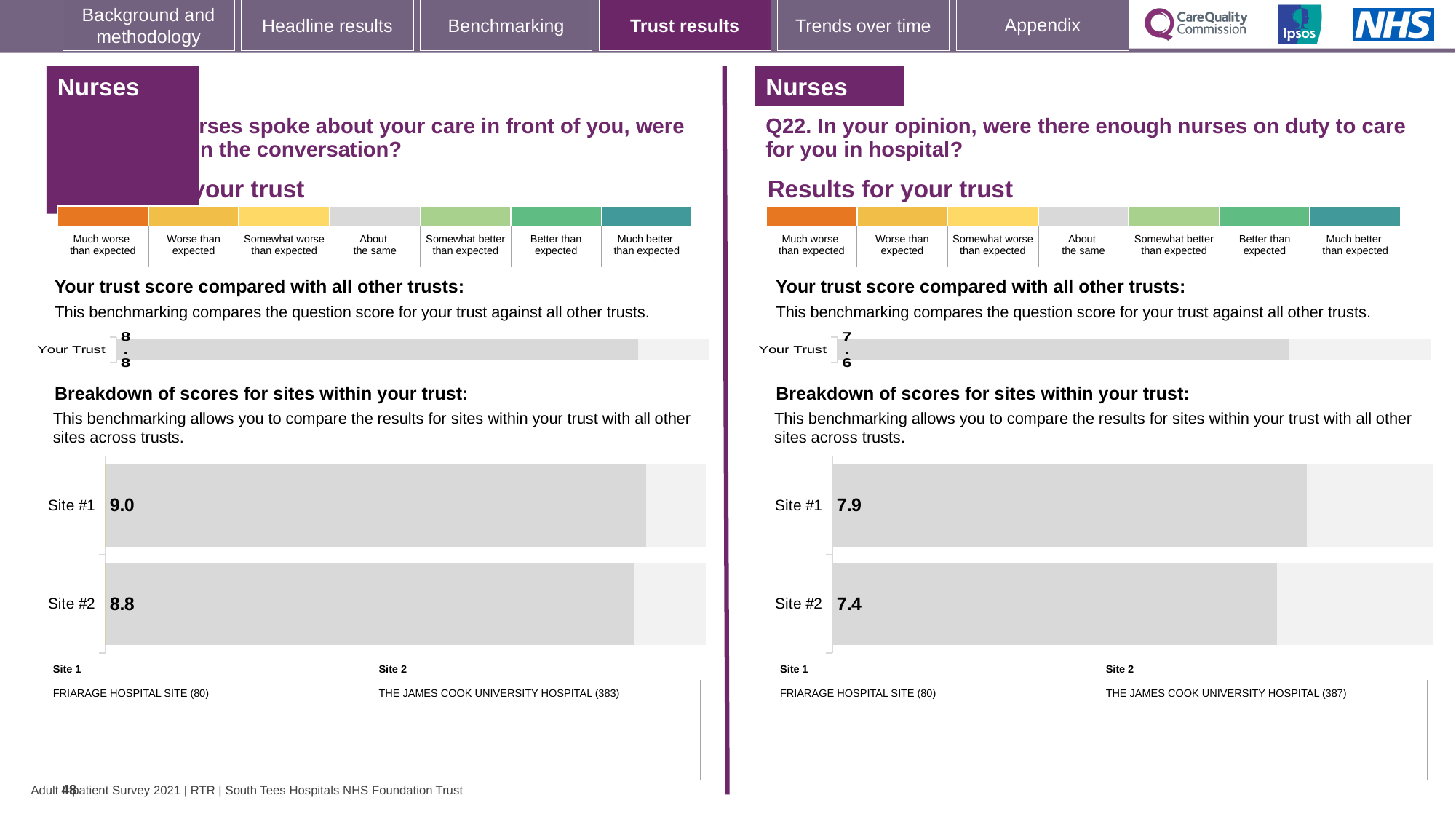
How many sites are shown in the breakdown chart on the right-hand side for Q22? 2 On the left-hand chart, what is the score shown for Site #1? 9.0 On the right-hand chart for Q22, what is the difference between the Site #1 and Site #2 scores? 0.5 On the right-hand chart for Q22, what is the score shown for Site #1? 7.9 What type of chart is used for the breakdown of scores for sites within your trust? Bar chart On the left-hand 'Your trust score compared with all other trusts' chart, what is the value for Your Trust? 8.8 On the right-hand 'Your trust score compared with all other trusts' chart for Q22, what is the value for Your Trust? 7.6 On the left-hand chart, what is the score shown for Site #2? 8.8 On the right-hand chart for Q22, which site has the higher score? Site #1 On the right-hand chart for Q22, what is the score shown for Site #2? 7.4 On the left-hand chart, which site has the lower score? Site #2 On the left-hand chart, what is the difference between the Site #1 and Site #2 scores? 0.2